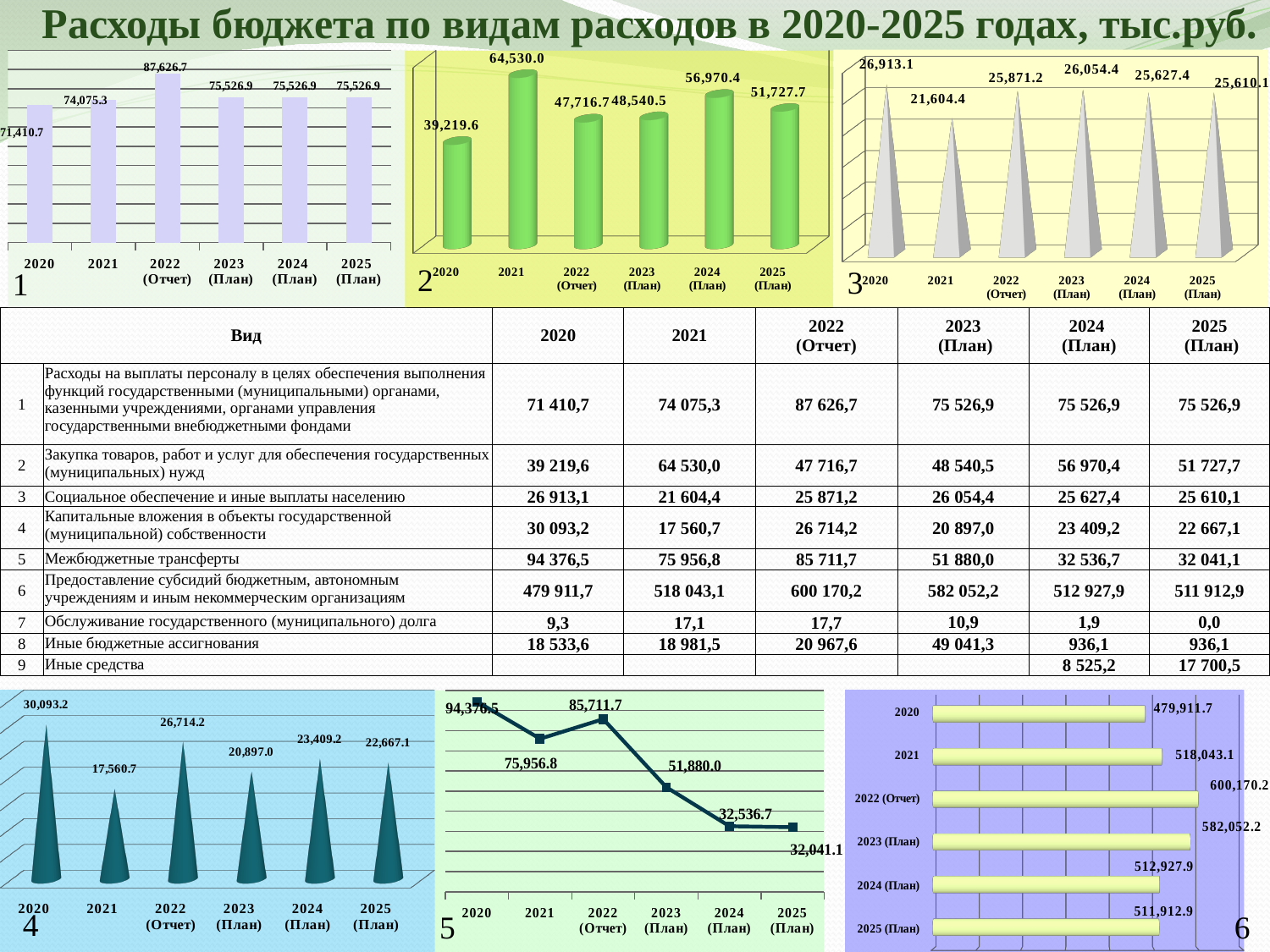
In chart 2 (top-middle), what is the value for 2021? 64,530.0 In chart 2 (top-middle), what is the difference between the values for 2021 and 2020? 25,310.4 In chart 1 (top-left), what is the value for 2022 (Отчет)? 87,626.7 In chart 1 (top-left), which year has the highest value? 2022 (Отчет) How many years are shown on the x axis of chart 1 (top-left)? 6 In chart 5 (bottom-middle), what is the value for 2025 (План)? 32,041.1 In chart 2 (top-middle), which year has the lowest value? 2020 What kind of chart is chart 5 (bottom-middle)? line chart In chart 4 (bottom-left), which year has the highest value? 2020 In chart 3 (top-right), what is the value for 2021? 21,604.4 In chart 4 (bottom-left), is the value for 2021 larger or smaller than the value for 2022 (Отчет)? smaller In chart 6 (bottom-right), which year has the highest value? 2022 (Отчет)